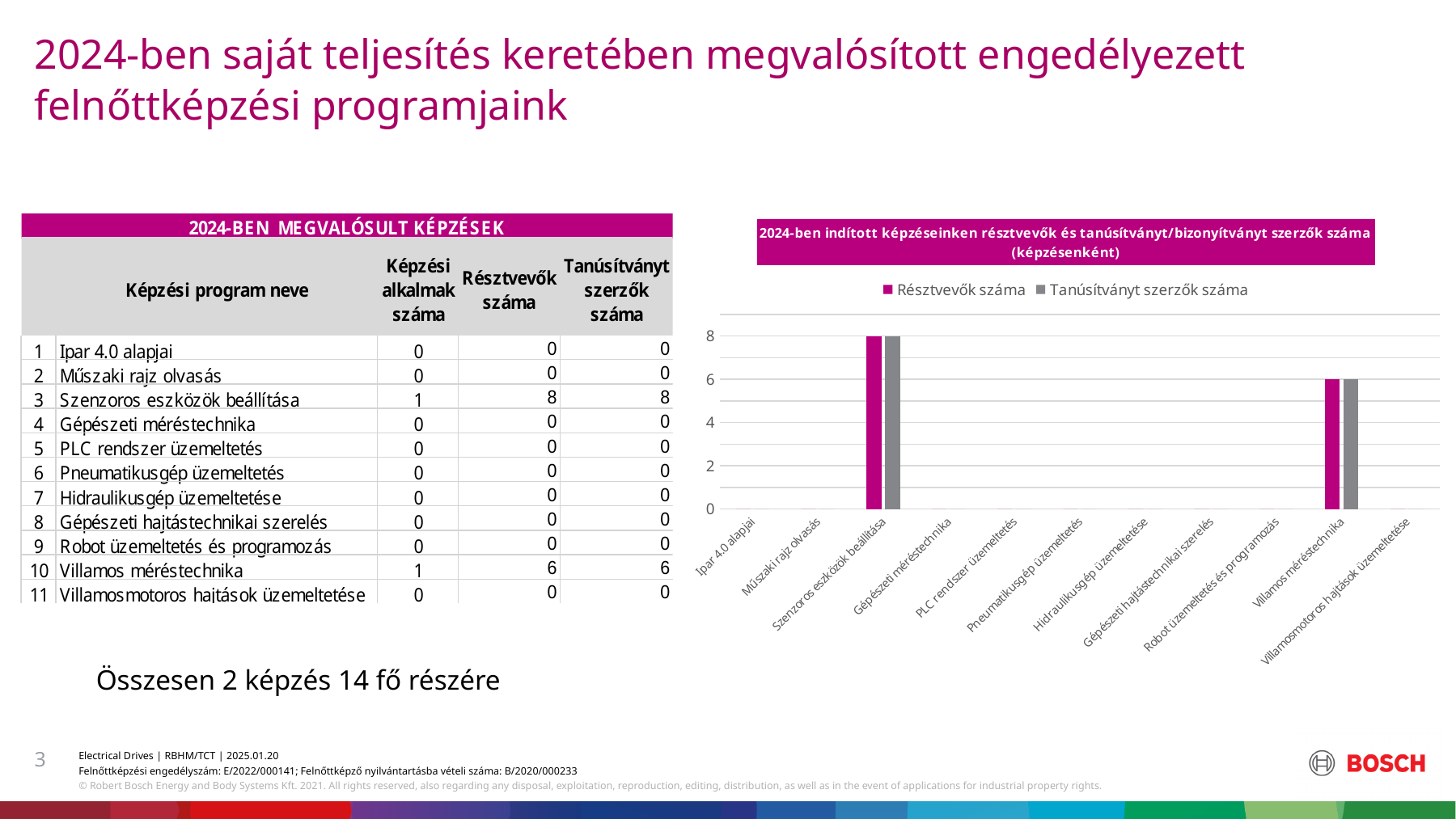
Which series in the legend is shown in grey? Tanúsítványt szerzők száma What is the difference between the Résztvevők száma values for Szenzoros eszközök beállítása and Villamos méréstechnika? 2 Which is larger: Tanúsítványt szerzők száma for Szenzoros eszközök beállítása or for Villamos méréstechnika? Szenzoros eszközök beállítása What is the value of Tanúsítványt szerzők száma for Villamos méréstechnika? 6 What is the value of Résztvevők száma for Szenzoros eszközök beállítása? 8 What kind of chart is shown on the slide? bar chart Is the value of Résztvevők száma for Villamos méréstechnika greater or less than 4? greater What is the value of Résztvevők száma for Ipar 4.0 alapjai? 0 How many series does the chart legend list? 2 How many categories have a non-zero value for Résztvevők száma? 2 How many categories are shown on the x axis of the chart? 11 Which category has the highest value for Résztvevők száma? Szenzoros eszközök beállítása